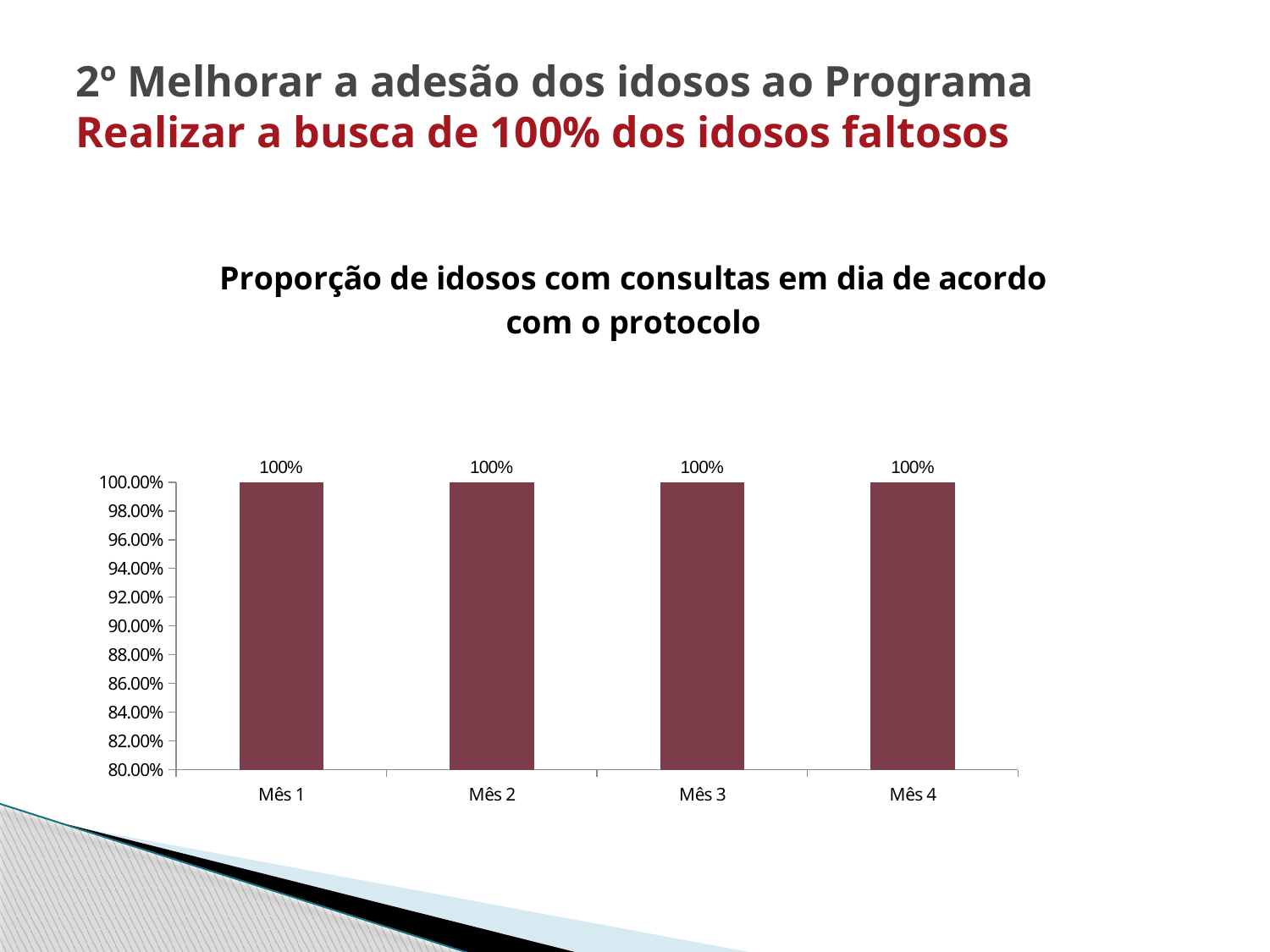
How many categories are shown on the x axis? 4 What kind of chart is shown on the slide? bar chart What is the value for Mês 1? 100% What is the difference between the values for Mês 1 and Mês 4? 0% Is the value for Mês 3 greater or less than 96.00%? greater Do the values rise, fall or stay the same from Mês 1 to Mês 4? stay the same What is the title of the chart? Proporção de idosos com consultas em dia de acordo com o protocolo What is the lowest value shown on the y axis? 80.00% Is the value for Mês 2 greater or less than 90.00%? greater What is the value for Mês 3? 100% What is the value for Mês 4? 100% What is the value for Mês 2? 100%